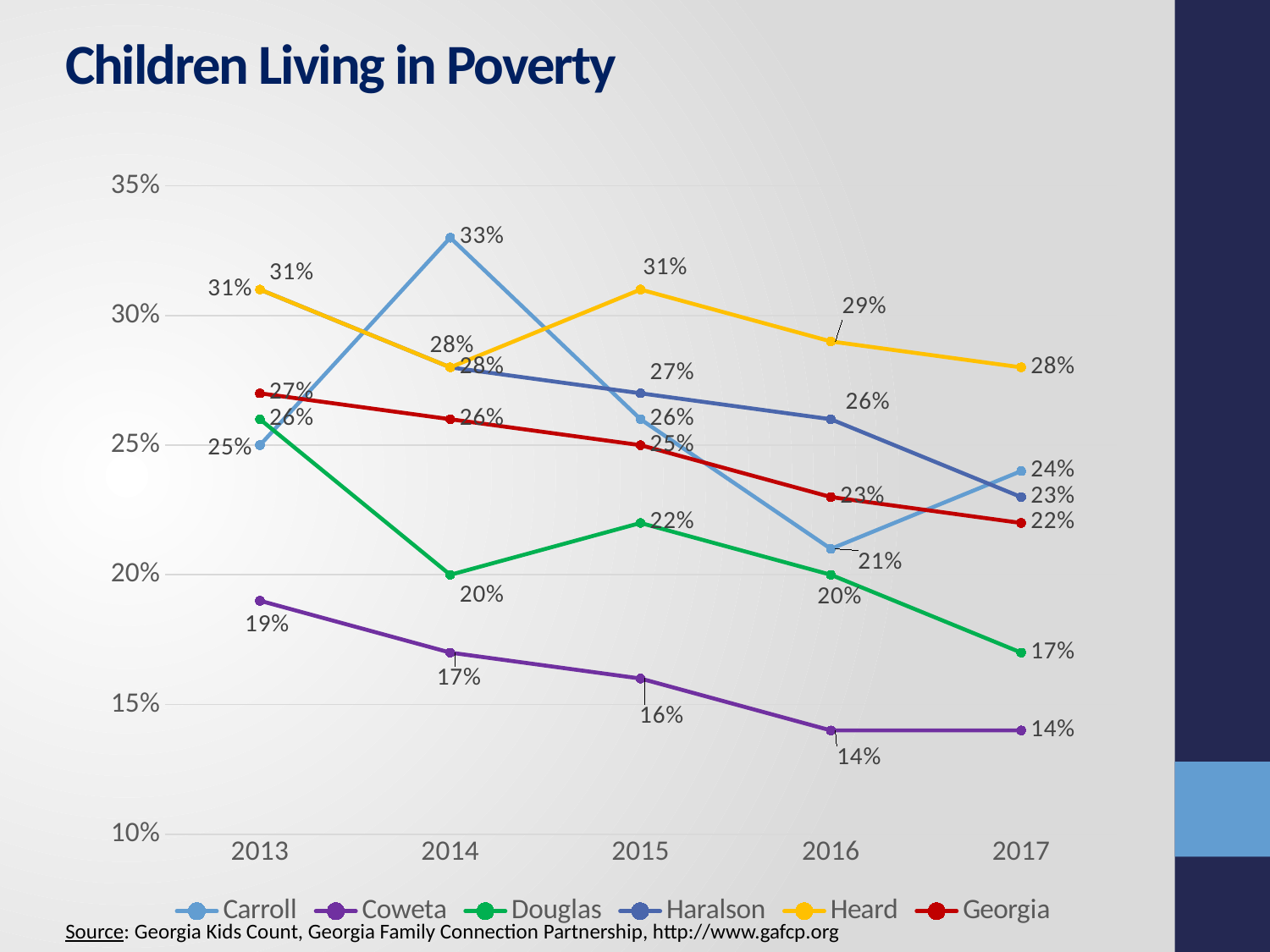
In 2015, which is larger, Douglas or Georgia? Georgia What is the value for Heard in 2015? 31% Which series has the highest value in 2014? Carroll What is the difference between Heard and Coweta in 2017? 14 percentage points What is the value for Georgia in 2013? 27% How many series does the legend list? 6 What is the value for Coweta in 2017? 14% How many years are shown on the x axis? 5 What is the value for Carroll in 2014? 33% Which series has the lowest value in 2017? Coweta What is the value for Douglas in 2017? 17% What kind of chart is shown on the slide? Line chart